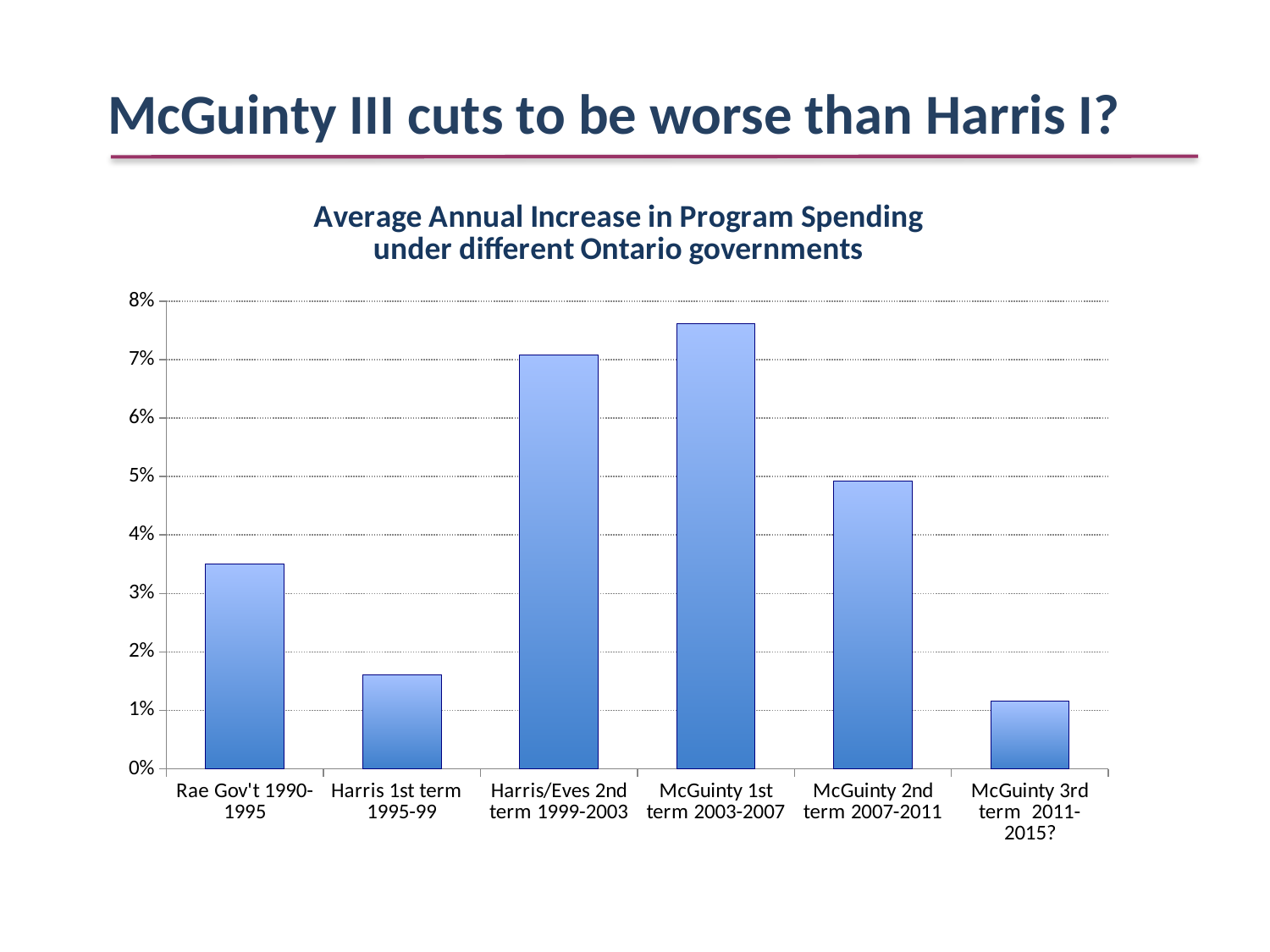
Is the value for Harris 1st term 1995-99 greater or less than 2%? less Is the value for McGuinty 3rd term 2011-2015? greater or less than 1%? greater How many Ontario government terms are plotted in the chart? 6 Which government term has the lowest average annual increase in program spending? McGuinty 3rd term 2011-2015? What is the title of the chart? Average Annual Increase in Program Spending under different Ontario governments What kind of chart is shown on the slide? bar chart Is the value for Rae Gov't 1990-1995 greater or less than 3%? greater Which has a larger average annual increase in program spending: Rae Gov't 1990-1995 or Harris 1st term 1995-99? Rae Gov't 1990-1995 Which has a larger average annual increase in program spending: McGuinty 2nd term 2007-2011 or Harris/Eves 2nd term 1999-2003? Harris/Eves 2nd term 1999-2003 Which government term has the highest average annual increase in program spending? McGuinty 1st term 2003-2007